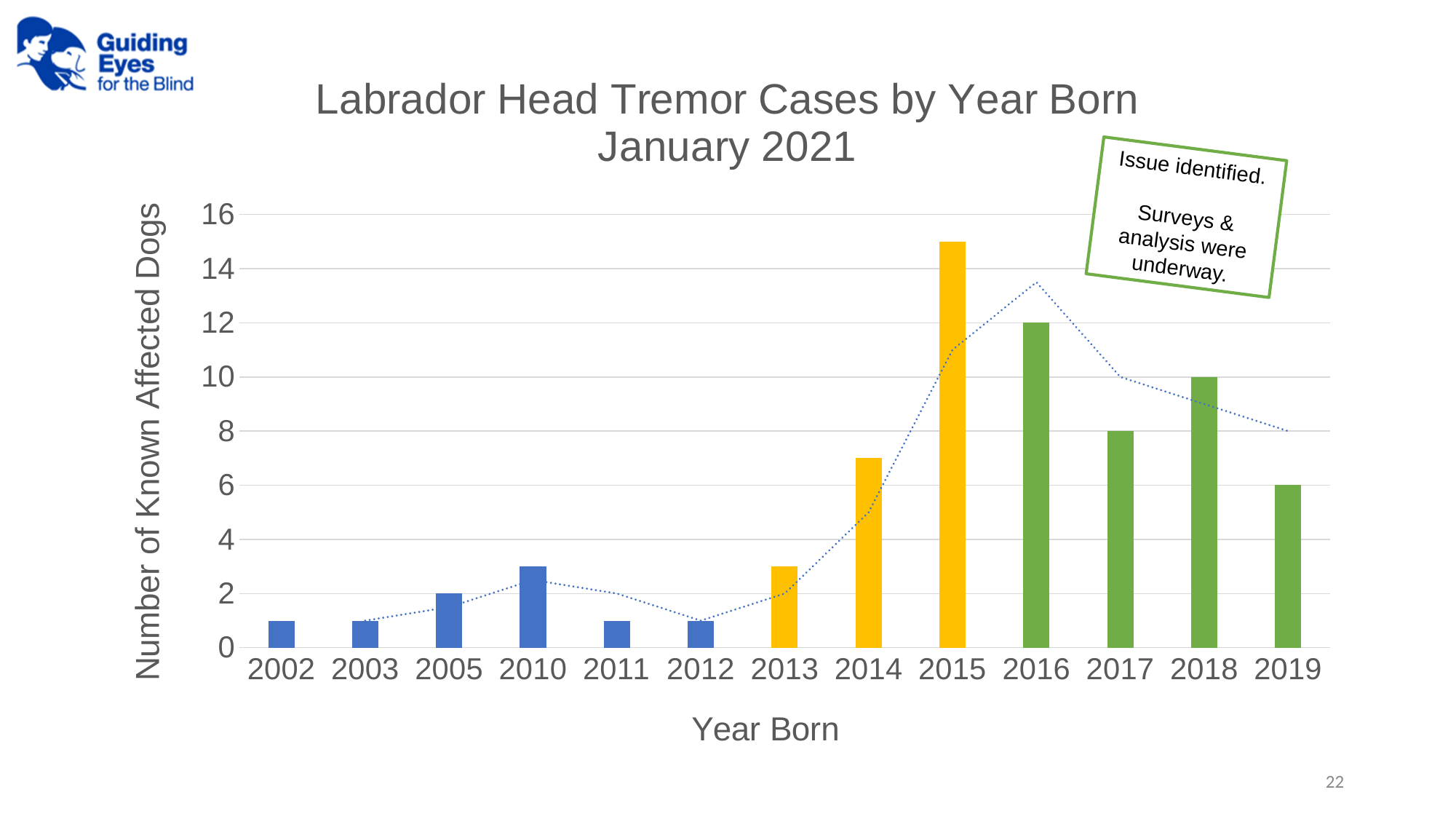
What is the number of known affected dogs for dogs born in 2019? 6 Which year born has the highest number of known affected dogs? 2015 Do the values rise or fall from 2015 to 2019? fall What is the number of known affected dogs for dogs born in 2016? 12 Is the value for dogs born in 2015 greater or less than 14? greater How many year-born categories are shown on the x axis? 13 What type of chart is shown on the slide? bar chart What is the difference in known affected dogs between dogs born in 2016 and dogs born in 2017? 4 Which has more known affected dogs: dogs born in 2015 or dogs born in 2016? 2015 What is the number of known affected dogs for dogs born in 2017? 8 What is the number of known affected dogs for dogs born in 2018? 10 Is the value for dogs born in 2014 greater or less than 8? less